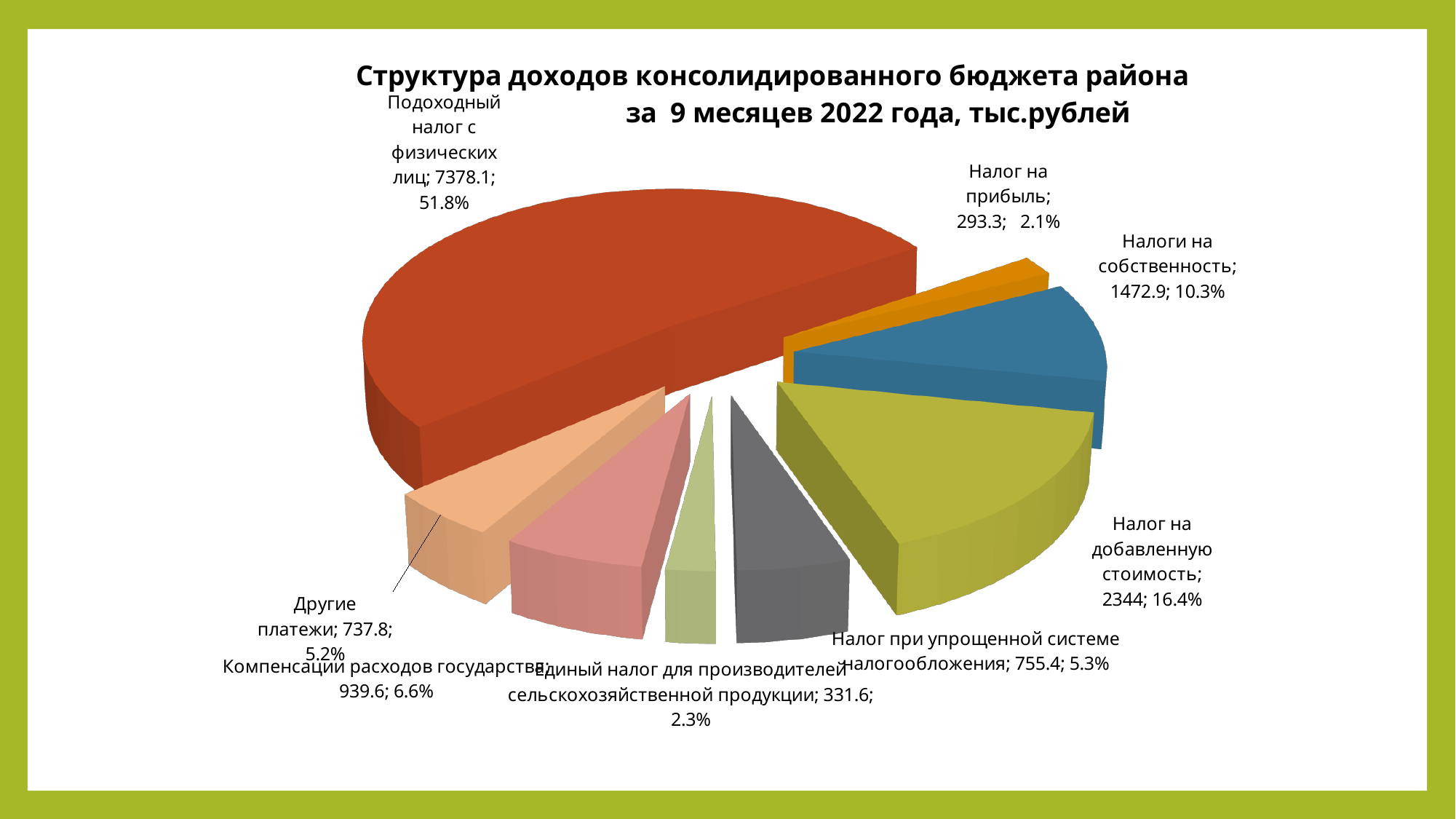
Which category has the smallest slice of the pie? Налог на прибыль How many categories are shown in the pie chart? 8 Which category has the largest slice of the pie? Подоходный налог с физических лиц What kind of chart is shown on the slide? Pie chart What share of the pie does Налог при упрощенной системе налогообложения represent? 5.3% Which is larger, the value for Компенсации расходов государства or the value for Другие платежи? Компенсации расходов государства What is the value for Налоги на собственность? 1472.9 What is the difference between the values for Налог на добавленную стоимость and Налоги на собственность? 871.1 What is the value for Подоходный налог с физических лиц? 7378.1 What is the title of the chart? Структура доходов консолидированного бюджета района за 9 месяцев 2022 года, тыс.рублей What is the value for Налог на добавленную стоимость? 2344 What share of the pie does Компенсации расходов государства represent? 6.6%